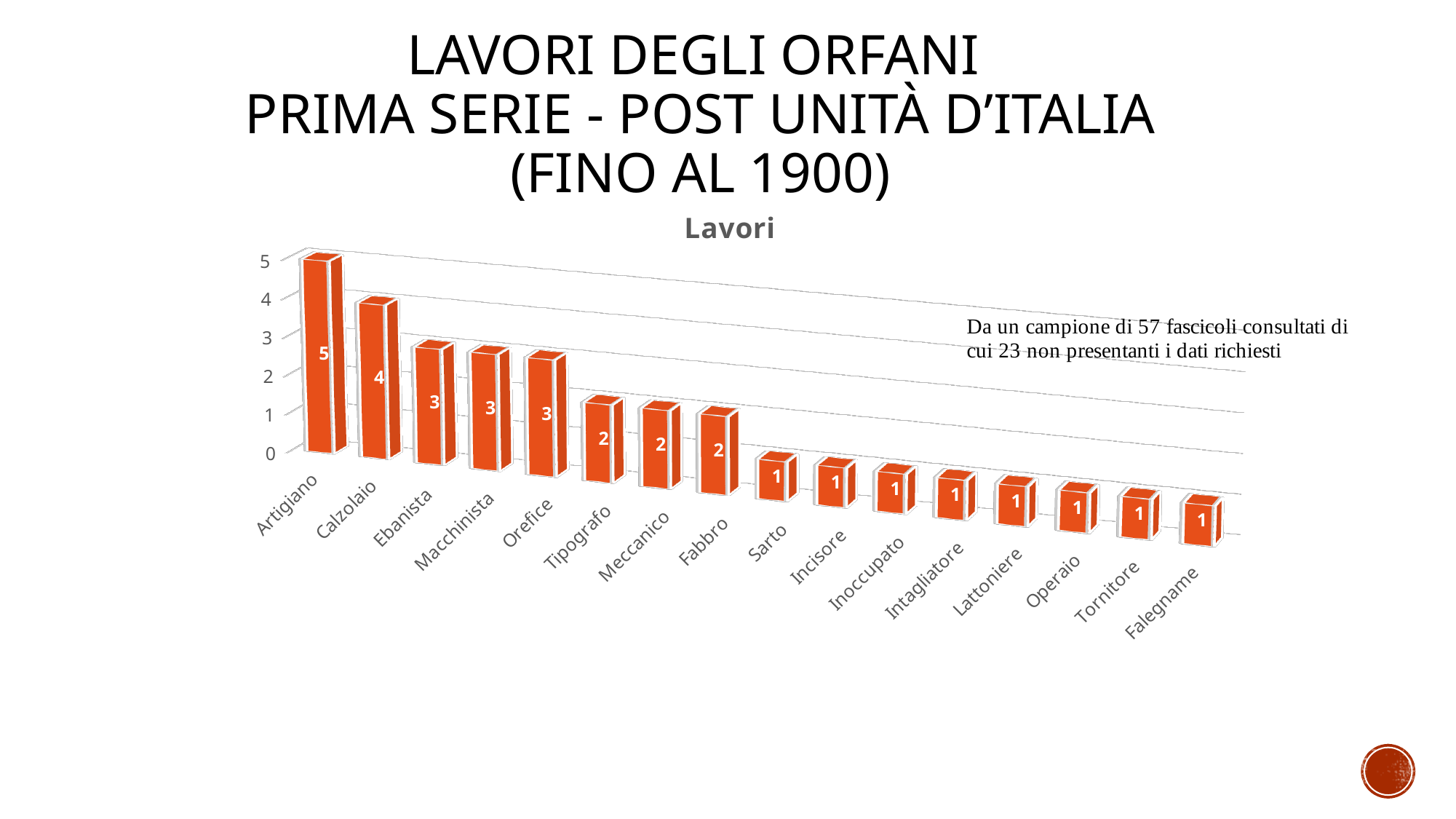
What is the title of the chart on the slide? Lavori What is the difference between the values for Ebanista and Fabbro? 1 Which category has the highest value in the Lavori chart? Artigiano What is the value for Calzolaio in the Lavori chart? 4 What is the value for Tipografo in the Lavori chart? 2 What is the difference between the values for Artigiano and Calzolaio? 1 How many categories are shown in the Lavori chart? 16 Which has a larger value, Orefice or Meccanico? Orefice Which has a larger value, Sarto or Calzolaio? Calzolaio What is the value for Falegname in the Lavori chart? 1 What is the value for Artigiano in the Lavori chart? 5 What kind of chart is shown on the slide? Bar chart